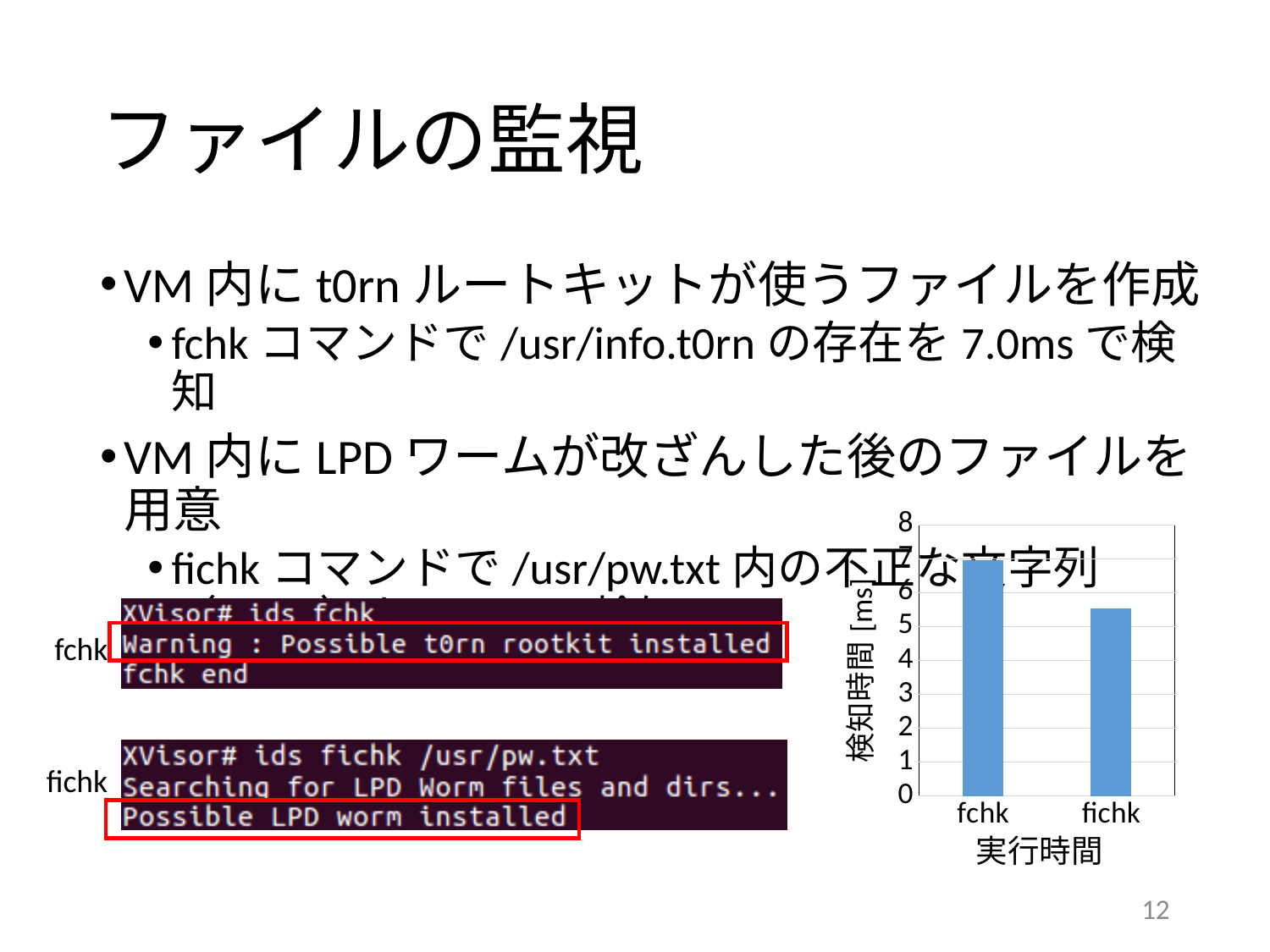
Is the value for fichk greater or less than 6? less Is the value for fchk greater or less than 8? less Is the value for fichk greater or less than 5? greater Which command has the higher detection time in the chart? fchk What kind of chart is shown on the slide? bar chart How many bars are plotted in the chart? 2 What is the title shown below the chart? 実行時間 What is the label of the vertical axis of the chart? 検知時間 [ms] Which command has the lower detection time in the chart? fichk Is the bar for fchk taller or shorter than the bar for fichk? taller